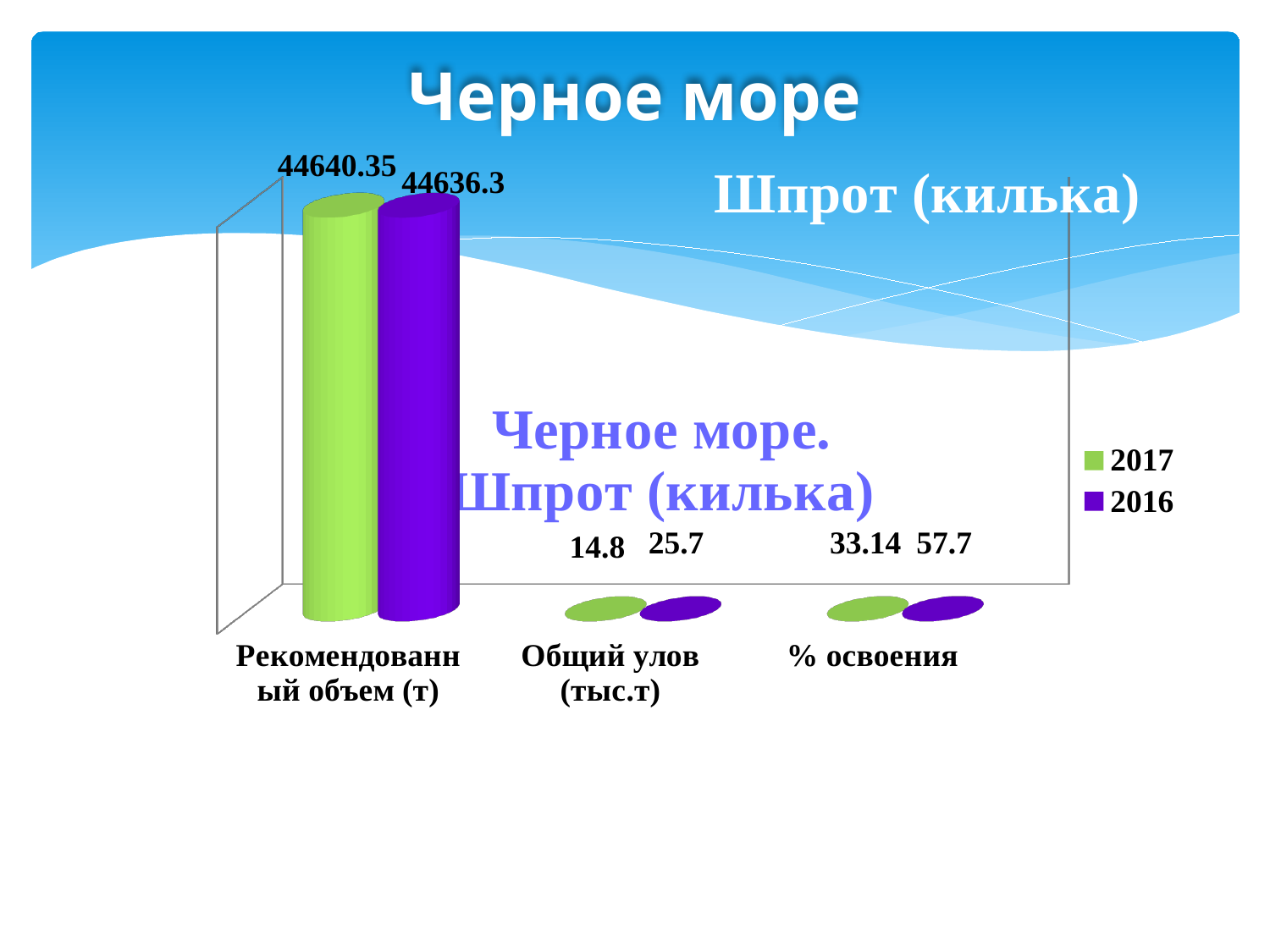
What is the value for 2016 in the category Общий улов (тыс.т)? 25.7 Which year has the larger value in the category % освоения, 2016 or 2017? 2016 What is the difference between the 2016 and 2017 values in the category Общий улов (тыс.т)? 10.9 What is the value for 2016 in the category % освоения? 57.7 What is the difference between the 2016 and 2017 values in the category % освоения? 24.56 What type of chart is shown on the slide? Bar chart How many categories are shown on the x axis of the chart? 3 What is the value for 2017 in the category Рекомендованный объем (т)? 44640.35 What is the value for 2017 in the category Общий улов (тыс.т)? 14.8 What is the value for 2017 in the category % освоения? 33.14 How many series does the chart legend list? 2 What is the value for 2016 in the category Рекомендованный объем (т)? 44636.3